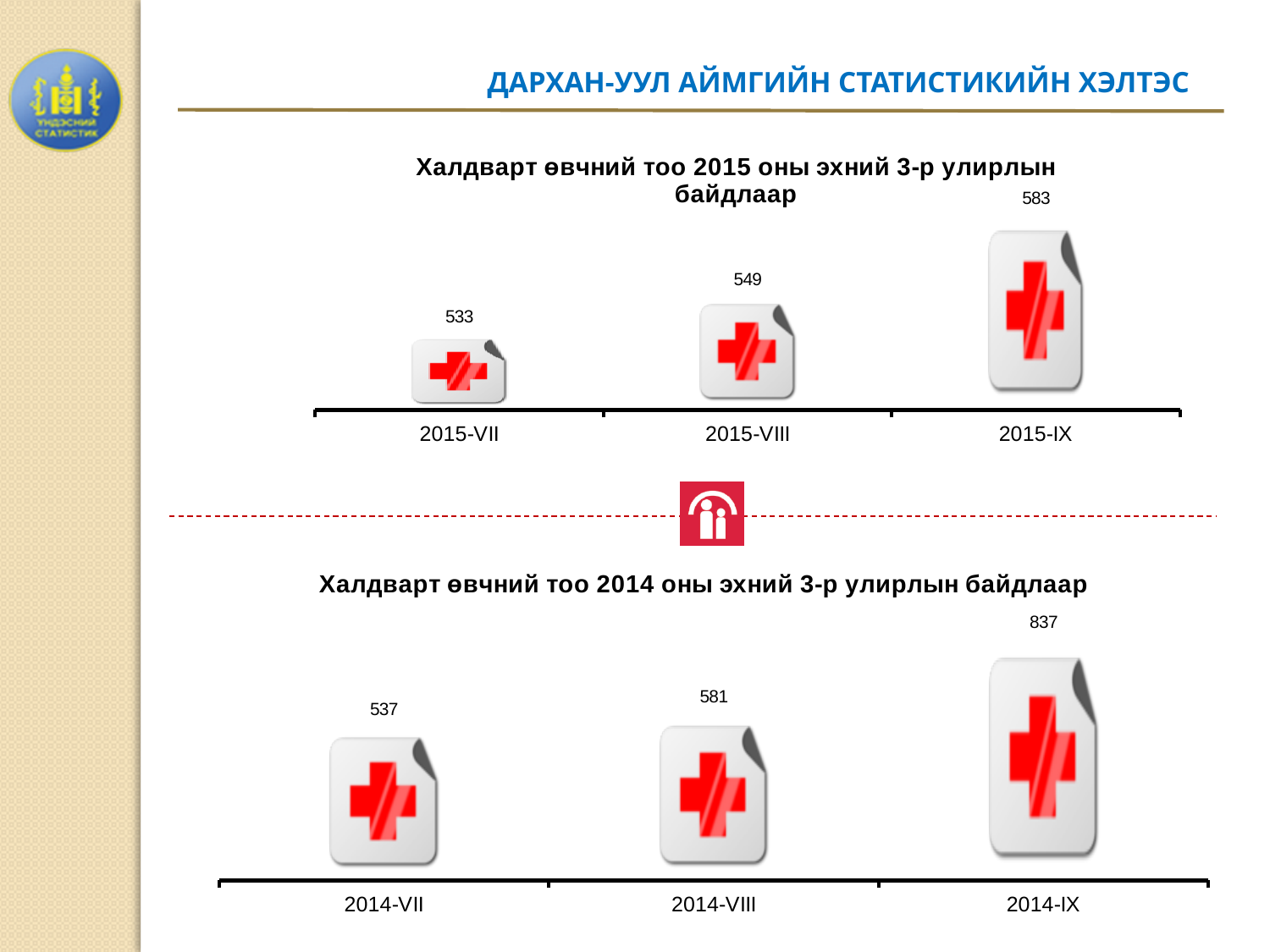
In the top chart (2015), which month has the highest value? 2015-IX Which is larger: the value for 2015-VIII in the top chart or the value for 2014-VIII in the bottom chart? 2014-VIII In the bottom chart (2014), what is the value for 2014-IX? 837 What is the title of the bottom chart? Халдварт өвчний тоо 2014 оны эхний 3-р улирлын байдлаар How many categories are shown on the x axis of the bottom chart (2014)? 3 In the top chart (2015), what is the value for 2015-IX? 583 In the top chart (2015), what is the value for 2015-VII? 533 In the bottom chart (2014), which month has the lowest value? 2014-VII In the bottom chart (2014), what is the difference between the values for 2014-IX and 2014-VIII? 256 In the bottom chart (2014), what is the value for 2014-VIII? 581 In the top chart (2015), do the values rise or fall from 2015-VII to 2015-IX? rise In the top chart (2015), what is the difference between the values for 2015-IX and 2015-VII? 50